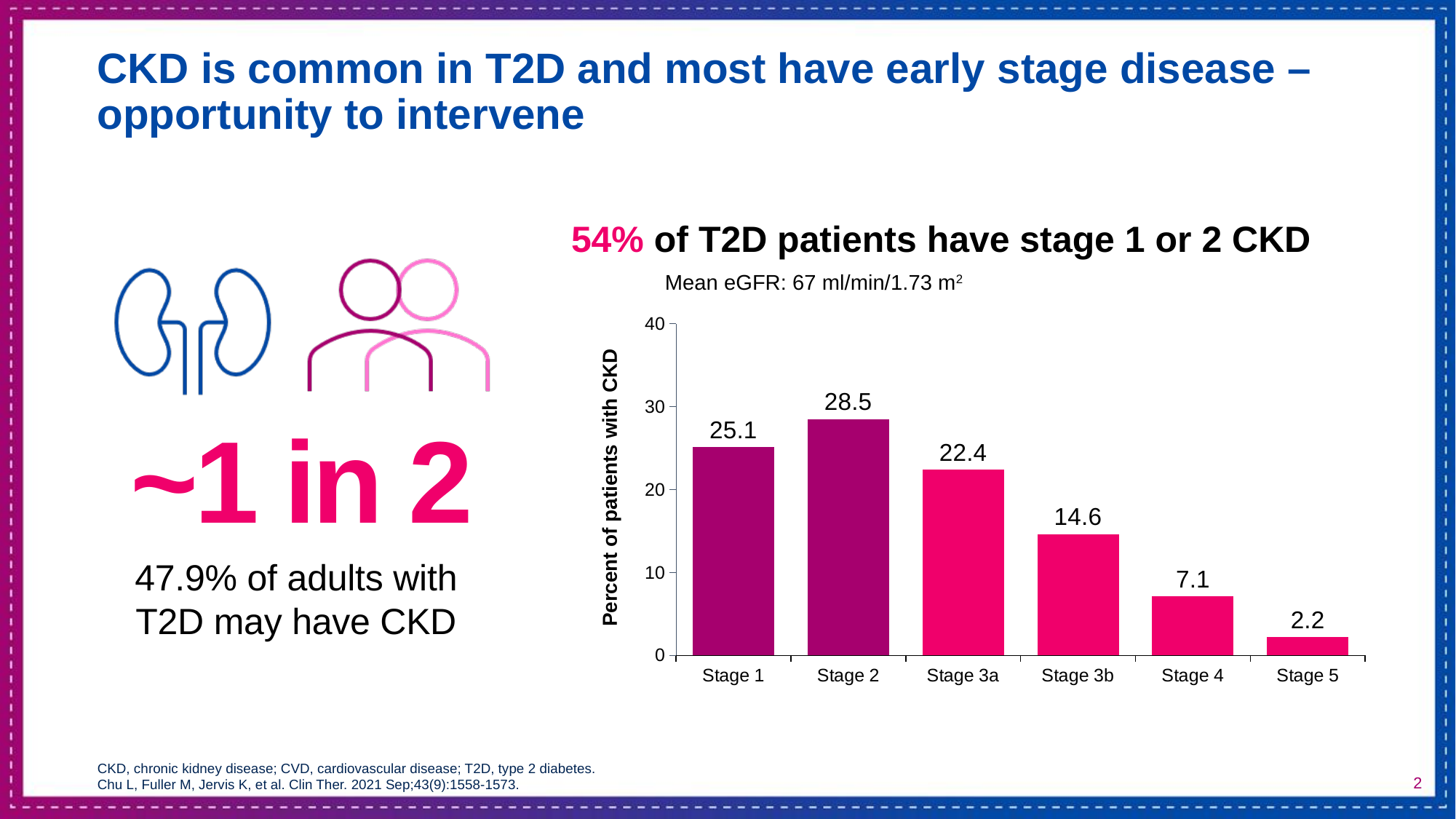
Is the value for Stage 1 greater or less than 20? greater What kind of chart is shown on the slide? bar chart Which stage has the lowest percent of patients with CKD? Stage 5 Which has a larger value, Stage 3a or Stage 3b? Stage 3a Which stage has the highest percent of patients with CKD? Stage 2 What is the percent of patients with CKD at Stage 5? 2.2 What is the label of the y axis of the chart? Percent of patients with CKD What is the percent of patients with CKD at Stage 2? 28.5 How many stages are shown on the x axis of the chart? 6 What is the difference between the values for Stage 2 and Stage 1? 3.4 What is the percent of patients with CKD at Stage 3b? 14.6 What is the difference between the values for Stage 3a and Stage 4? 15.3